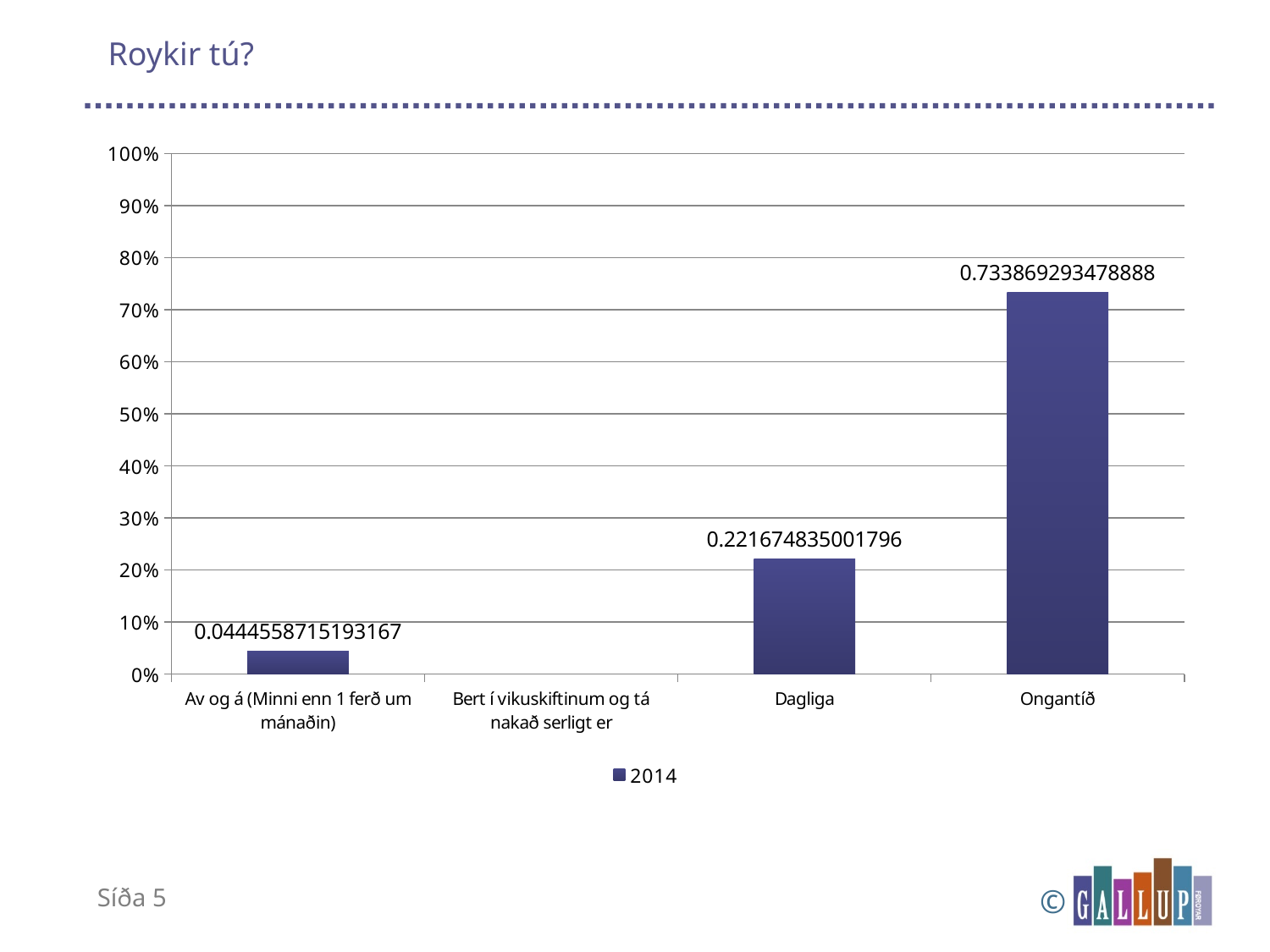
What is the value for Ongantíð? 0.733869293478888 What is the value for Av og á (Minni enn 1 ferð um mánaðin)? 0.0444558715193167 What kind of chart is shown on the slide? bar chart How many categories are shown on the x axis? 4 Is the value for Dagliga greater or less than 30%? less Is the value for Ongantíð greater or less than 70%? greater How many series does the legend list? 1 Which category has the highest value? Ongantíð What is the value for Dagliga? 0.221674835001796 Which of Dagliga or Av og á (Minni enn 1 ferð um mánaðin) has the larger value? Dagliga What series name is shown in the legend? 2014 Is the value for Av og á (Minni enn 1 ferð um mánaðin) greater or less than 10%? less